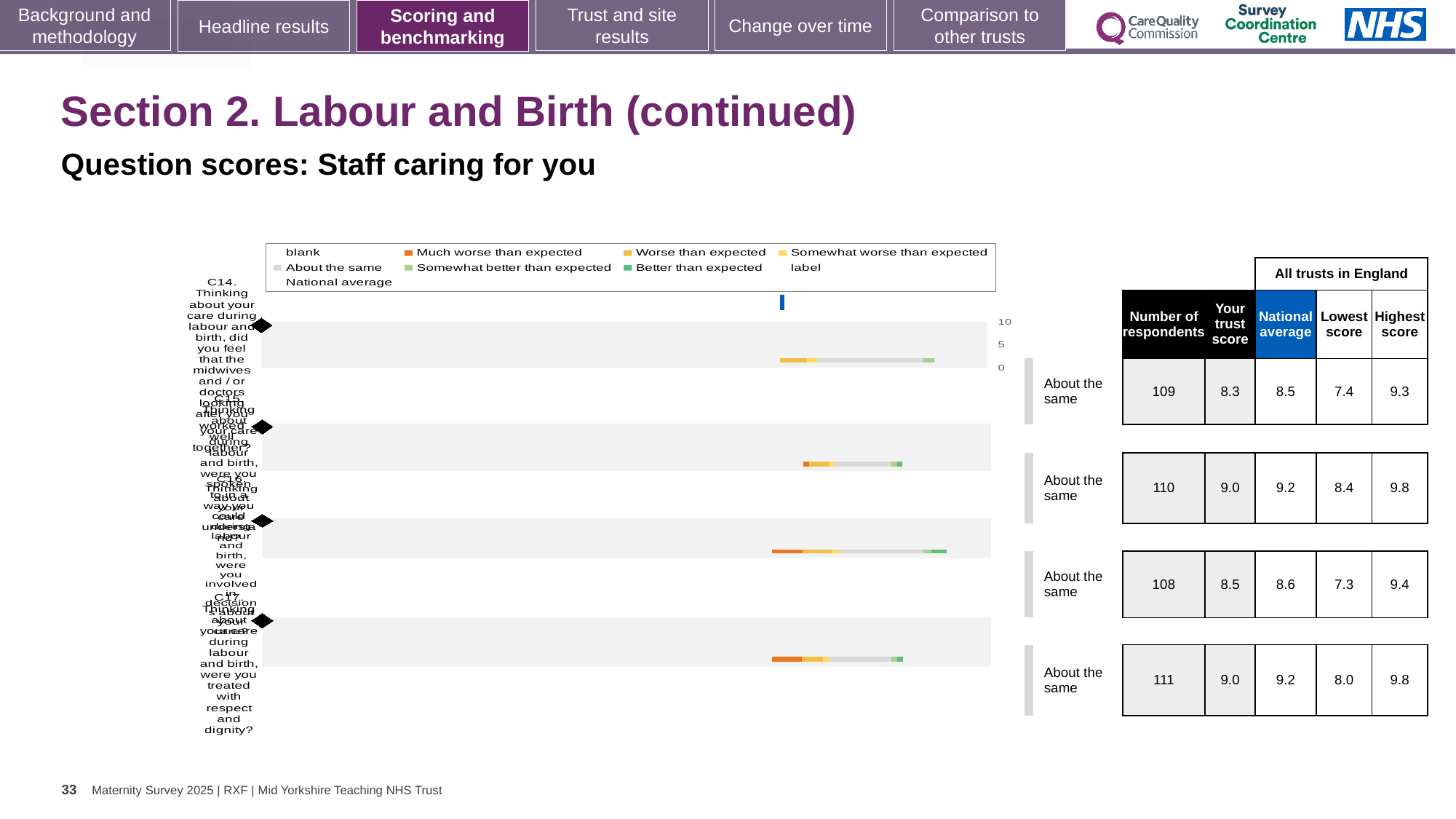
What is the subtitle above the chart? Question scores: Staff caring for you In the table beside the chart, what is the number of respondents for the first (top) row? 109 In the table beside the chart, which row has the highest number of respondents? the fourth (bottom) row, 111 In the chart legend, what colour is used for 'Much worse than expected'? orange In the table beside the chart, for the first (top) row, which is larger: the trust score or the national average? national average In the table beside the chart, what is the highest score for the fourth (bottom) row? 9.8 In the table beside the chart, what is the lowest score for the first (top) row? 7.4 In the table beside the chart, what is the national average for the third row? 8.6 How many question rows (categories) does the chart show? 4 In the table beside the chart, what is the trust score for the second row? 9.0 In the table beside the chart, which row has the lowest trust score? the first (top) row, 8.3 What kind of chart is shown on the slide? bar chart